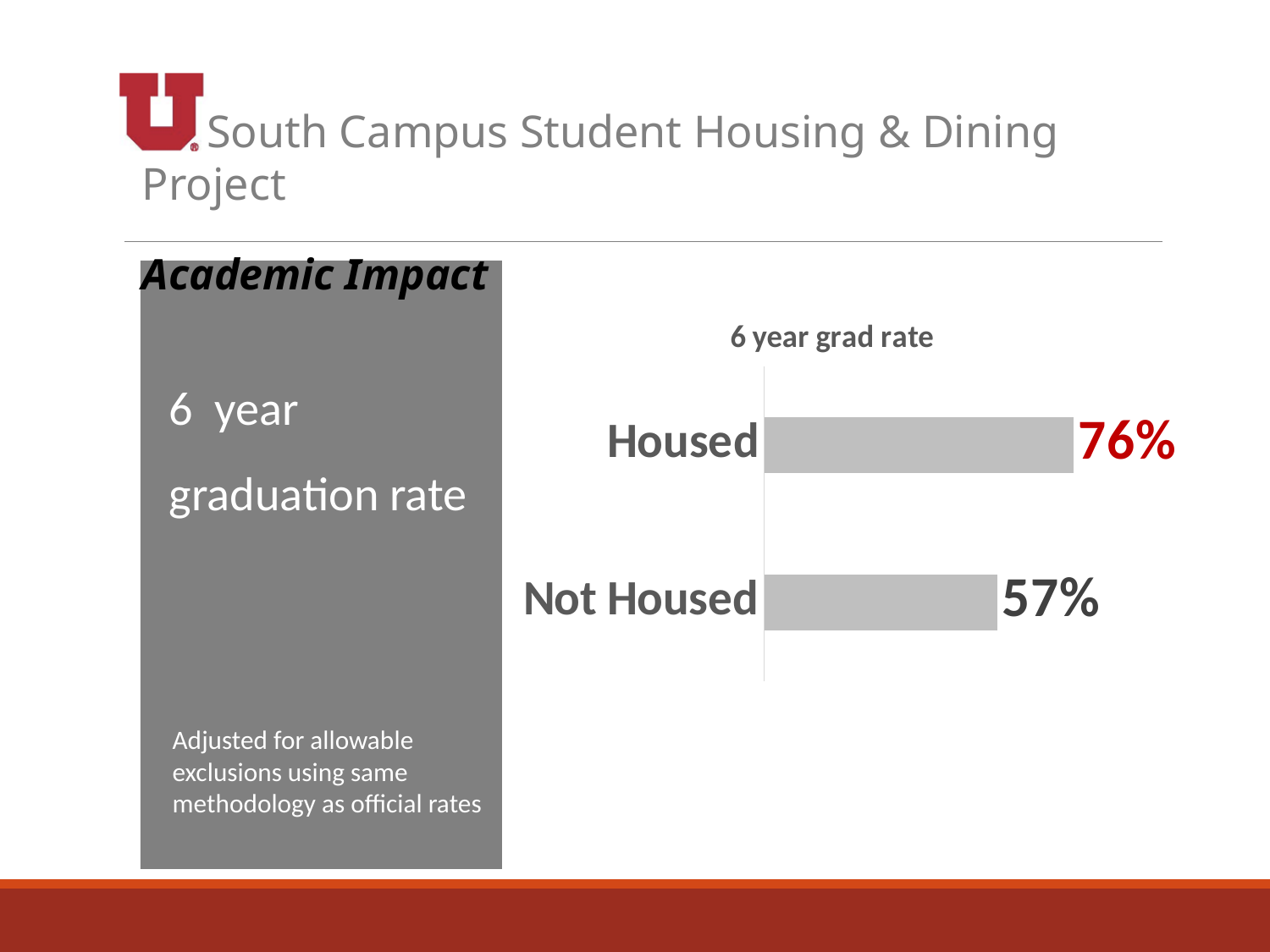
What is the 6 year grad rate for Not Housed students? 57% Which category has the higher 6 year grad rate? Housed What is the title of the chart? 6 year grad rate What is the difference in 6 year grad rate between Housed and Not Housed students? 19% What type of chart is shown on the slide? Bar chart Is the 6 year grad rate higher for Housed or Not Housed students? Housed How many categories are shown in the chart? 2 What is the 6 year grad rate for Housed students? 76% Which data label in the chart is shown in red? 76% Which category has the lower 6 year grad rate? Not Housed